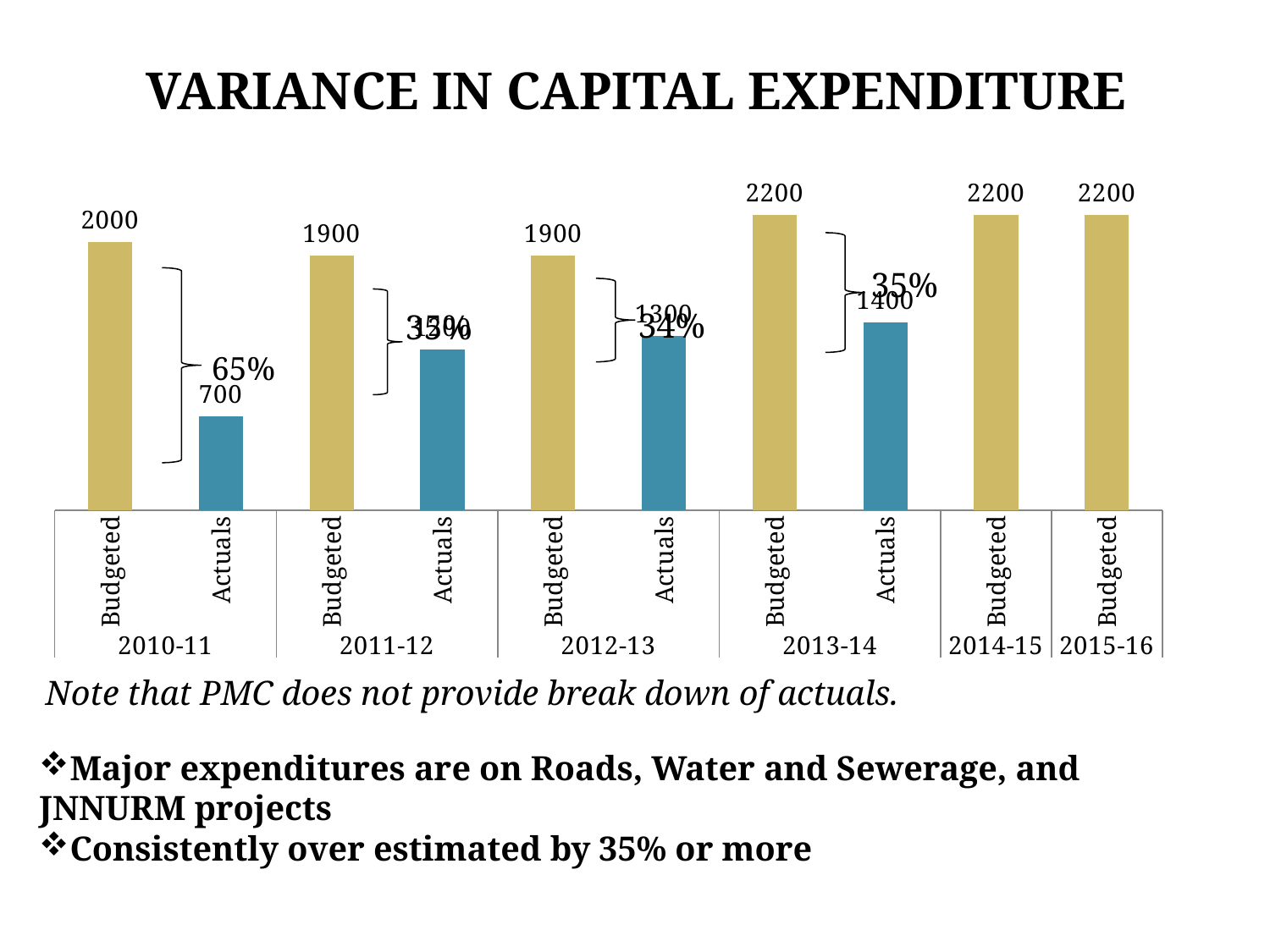
What is the difference between the Budgeted and Actuals values for 2010-11? 1300 What is the Actuals value for 2013-14? 1400 What variance percentage is annotated for 2010-11? 65% What is the Budgeted value for 2015-16? 2200 Which is larger, the Budgeted value for 2010-11 or the Budgeted value for 2011-12? 2010-11 What is the Actuals value for 2010-11? 700 How many fiscal years are shown on the x axis? 6 What is the Budgeted value for 2011-12? 1900 What kind of chart is shown on the slide? Bar chart What is the difference between the Budgeted and Actuals values for 2013-14? 800 Which year has the lowest Actuals value? 2010-11 What is the Budgeted value for 2010-11? 2000